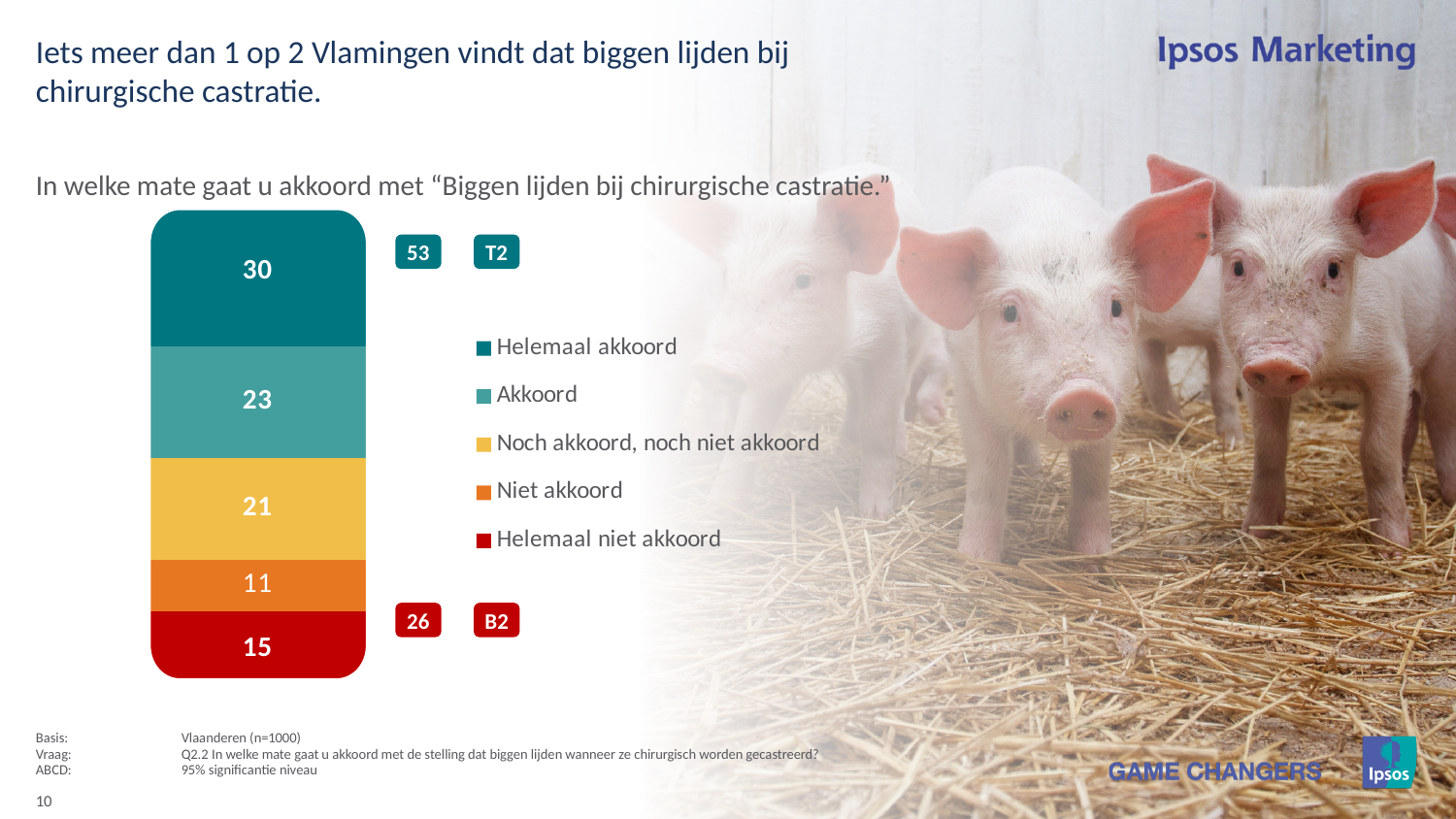
Which category has the highest value? Helemaal akkoord What is the difference between the values for "Helemaal akkoord" and "Helemaal niet akkoord"? 15 What value is shown for "Niet akkoord"? 11 What kind of chart is shown on the slide? Stacked bar chart Which is larger, the value for "Akkoord" or the value for "Noch akkoord, noch niet akkoord"? Akkoord What value is shown for "Helemaal niet akkoord"? 15 Which category has the lowest value? Niet akkoord What value is shown for "Noch akkoord, noch niet akkoord"? 21 What is the total of all segments in the stacked bar? 100 How many series does the legend list? 5 What value is shown for "Helemaal akkoord"? 30 What value is shown for "Akkoord"? 23